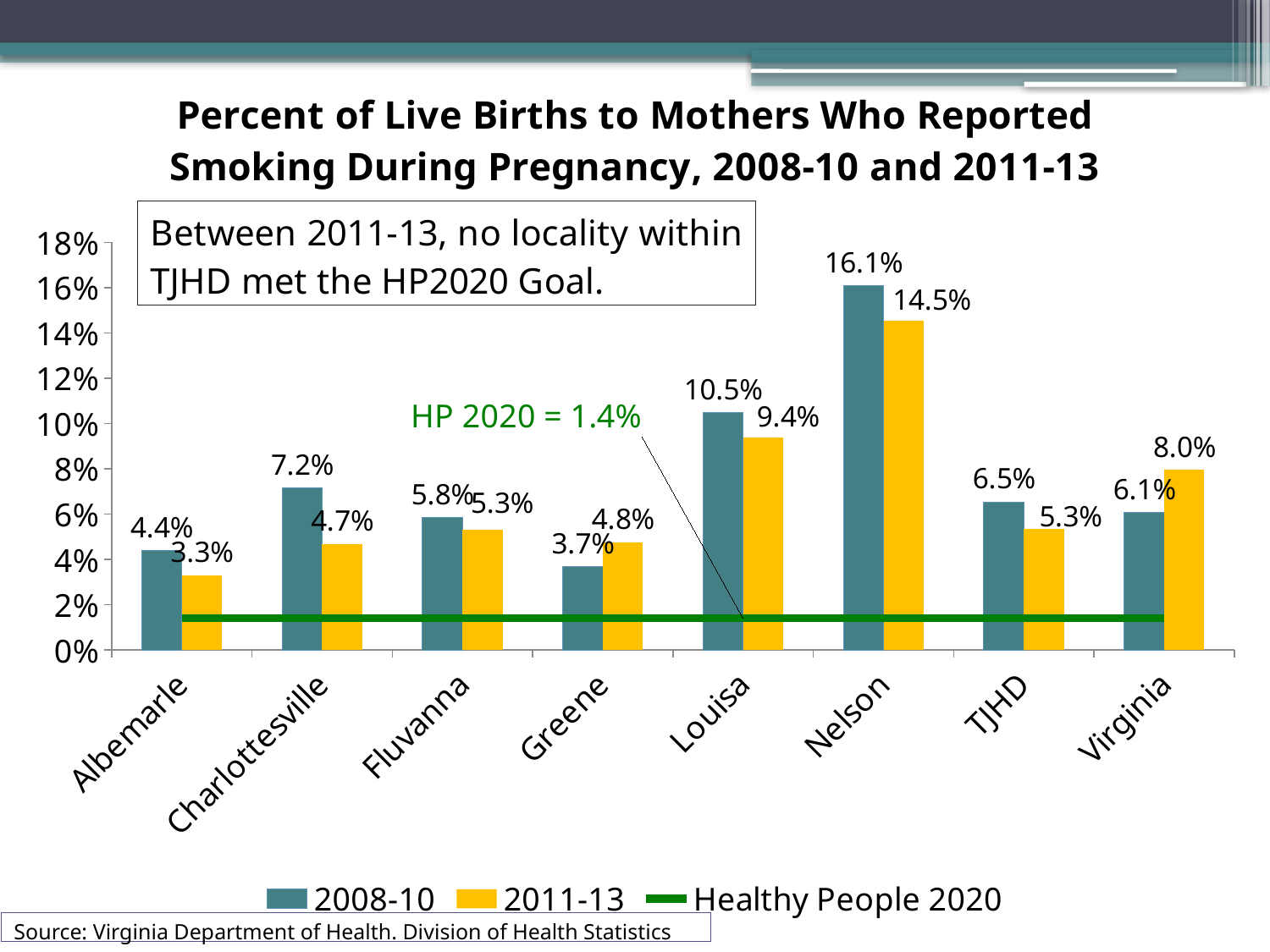
For Greene, which is larger: the 2008-10 value or the 2011-13 value? 2011-13 How many entries does the legend list? 3 Which locality has the lowest 2011-13 value? Albemarle How many localities are shown on the x axis? 8 What is the difference between the 2008-10 and 2011-13 values for Charlottesville? 2.5% What is the 2011-13 value for Nelson? 14.5% What kind of chart is shown on the slide? Bar chart What is the Healthy People 2020 goal value shown on the chart? 1.4% What is the 2011-13 value for Virginia? 8.0% Is the 2008-10 value for Nelson greater or less than 14%? greater Which locality has the highest 2008-10 value? Nelson What is the 2008-10 value for Louisa? 10.5%